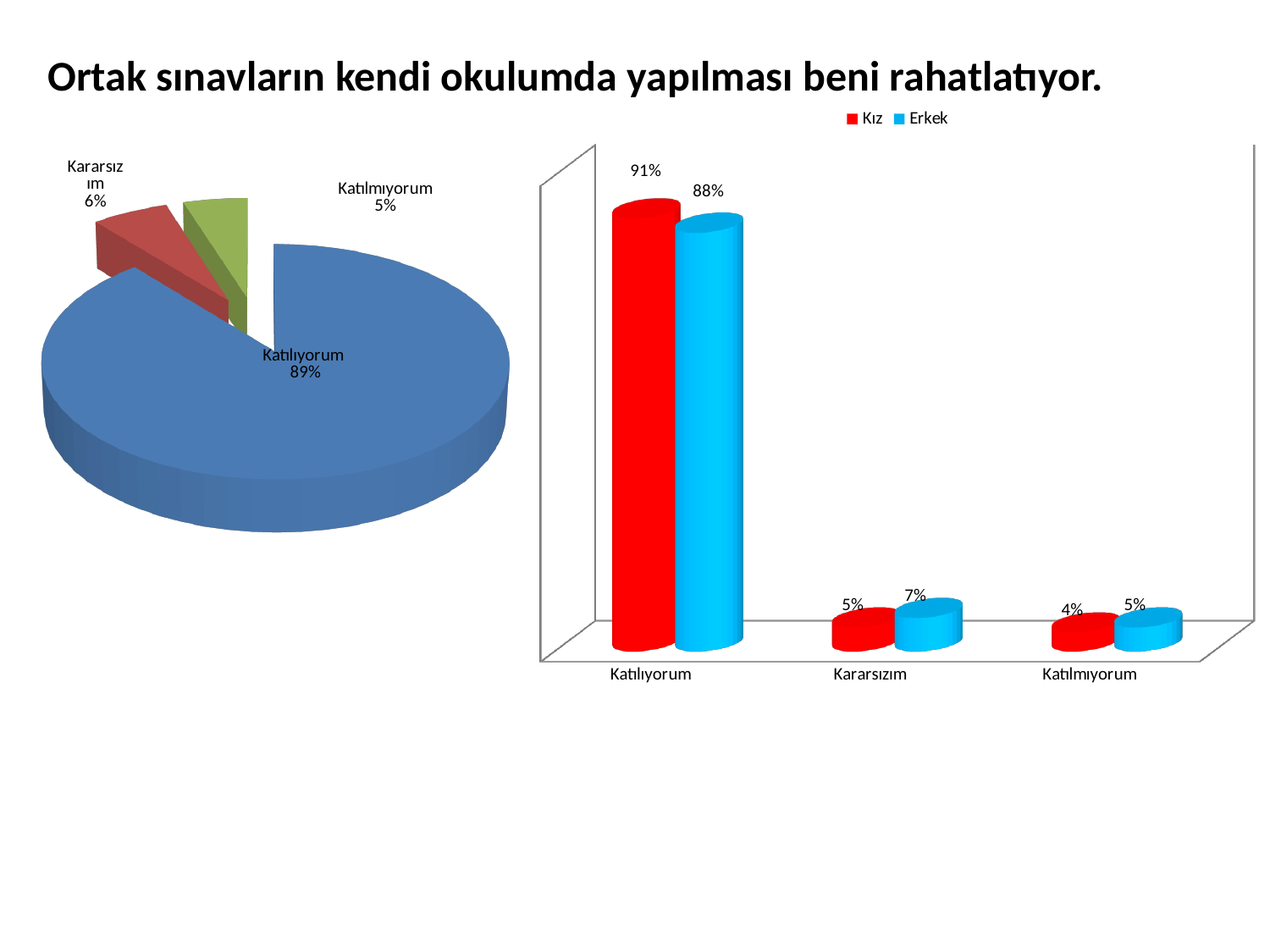
On the bar chart on the right, what is the Kız value for Katılıyorum? 91% On the pie chart on the left, what share does Katılıyorum have? 89% On the pie chart on the left, how many slices are there? 3 On the bar chart on the right, what is the Erkek value for Kararsızım? 7% On the bar chart on the right, which is larger for Kararsızım, Kız or Erkek? Erkek On the bar chart on the right, how many series does the legend list? 2 On the bar chart on the right, what is the difference between the Kız and Erkek values for Katılıyorum? 3% On the bar chart on the right, what is the Kız value for Katılmıyorum? 4% On the pie chart on the left, what share does Kararsızım have? 6% On the pie chart on the left, which category has the largest slice? Katılıyorum What kind of chart is on the right side of the slide? Bar chart On the pie chart on the left, which category has the smallest slice? Katılmıyorum